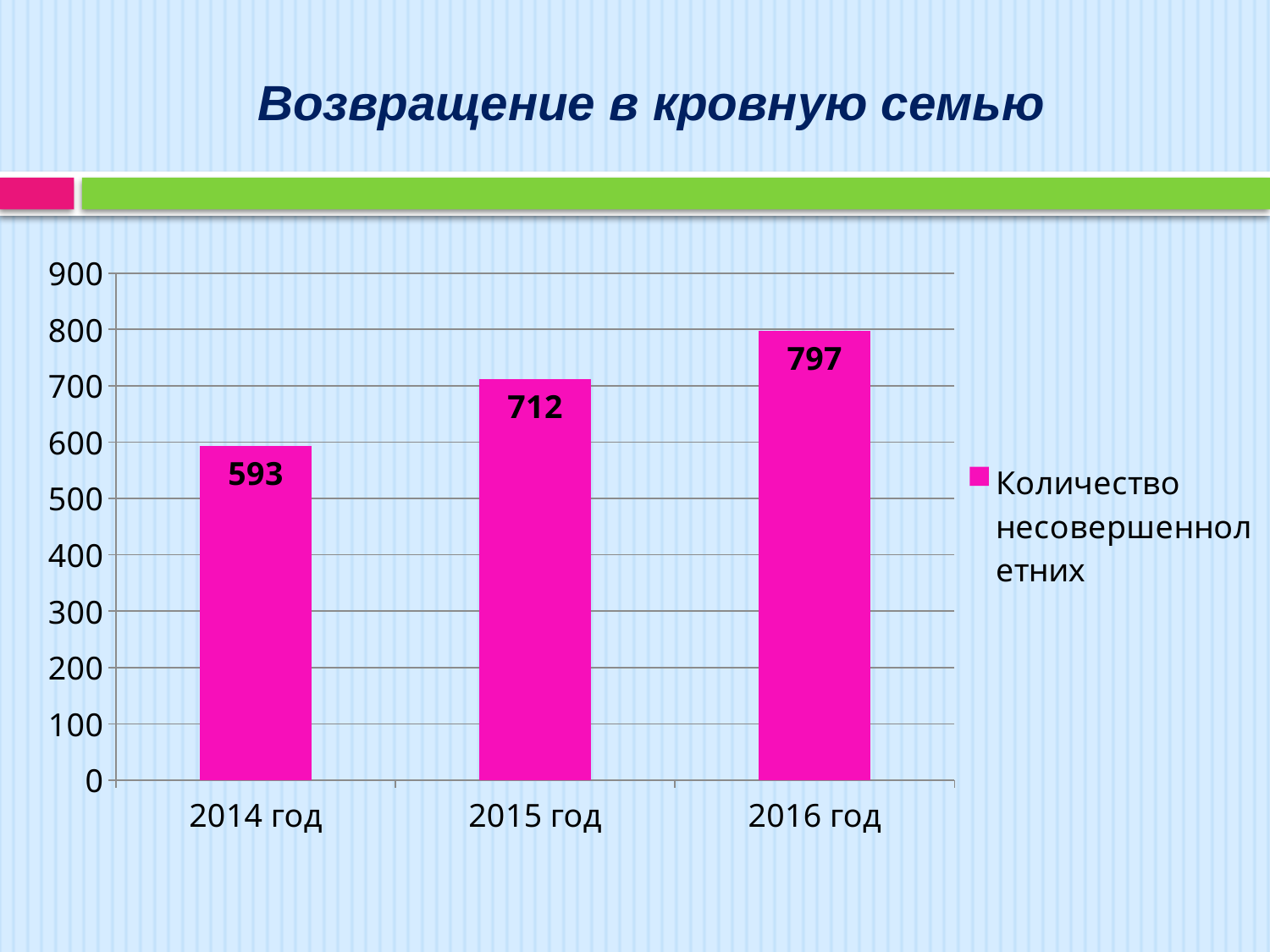
What is the difference between the values for 2015 год and 2014 год? 119 What is the value for 2014 год? 593 What is the value for 2015 год? 712 What kind of chart is shown on the slide? bar chart How many years are shown on the chart? 3 Do the values rise or fall from 2014 год to 2016 год? rise Which year has the lowest value? 2014 год Which year has the highest value? 2016 год What is the value for 2016 год? 797 Which is larger, the value for 2015 год or the value for 2016 год? 2016 год What is the difference between the values for 2016 год and 2014 год? 204 Is the value for 2014 год greater or less than 600? less